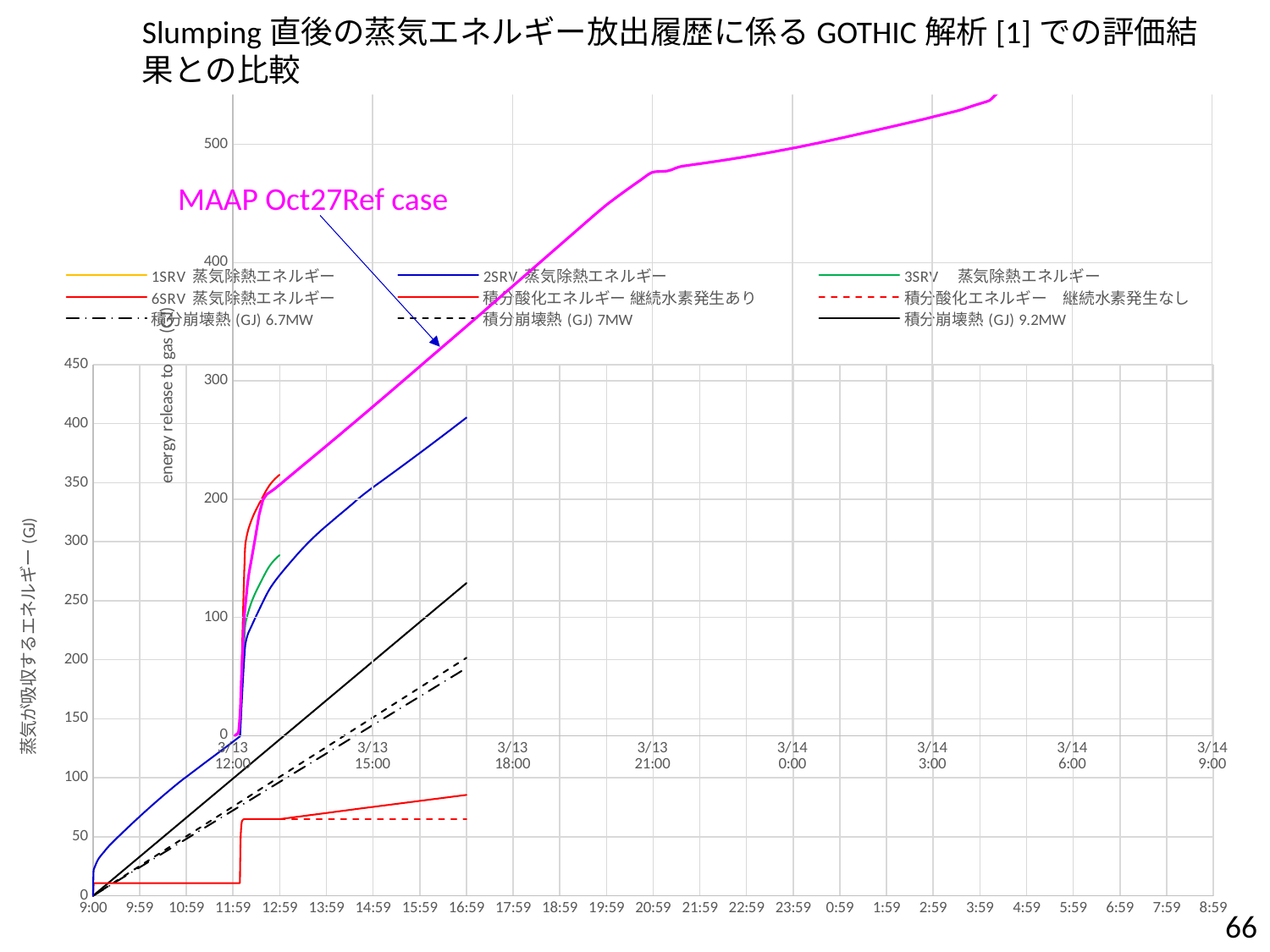
In the overlaid chart, does the MAAP Oct27Ref case line rise or fall over time? rise In the background chart, is the value of the dashed red 積分酸化エネルギー 継続水素発生なし line at 16:59 greater or less than 100? less In the overlaid chart, is the value of the MAAP Oct27Ref case line at 3/13 15:00 greater or less than 300? less What kind of chart is shown on the slide? line chart In the overlaid chart, is the value of the MAAP Oct27Ref case line at 3/13 21:00 greater or less than 400? greater In the overlaid chart, what is the y-axis title? energy release to gas (GJ) In the overlaid chart, what is the label of the magenta line? MAAP Oct27Ref case How many series does the legend of the background chart list? 9 In the background chart, at 12:59, which is higher: the 6SRV 蒸気除熱エネルギー line or the 3SRV 蒸気除熱エネルギー line? 6SRV 蒸気除熱エネルギー In the background chart, at 16:59, which is higher: the 積分崩壊熱 (GJ) 9.2MW line or the 積分崩壊熱 (GJ) 6.7MW line? 積分崩壊熱 (GJ) 9.2MW